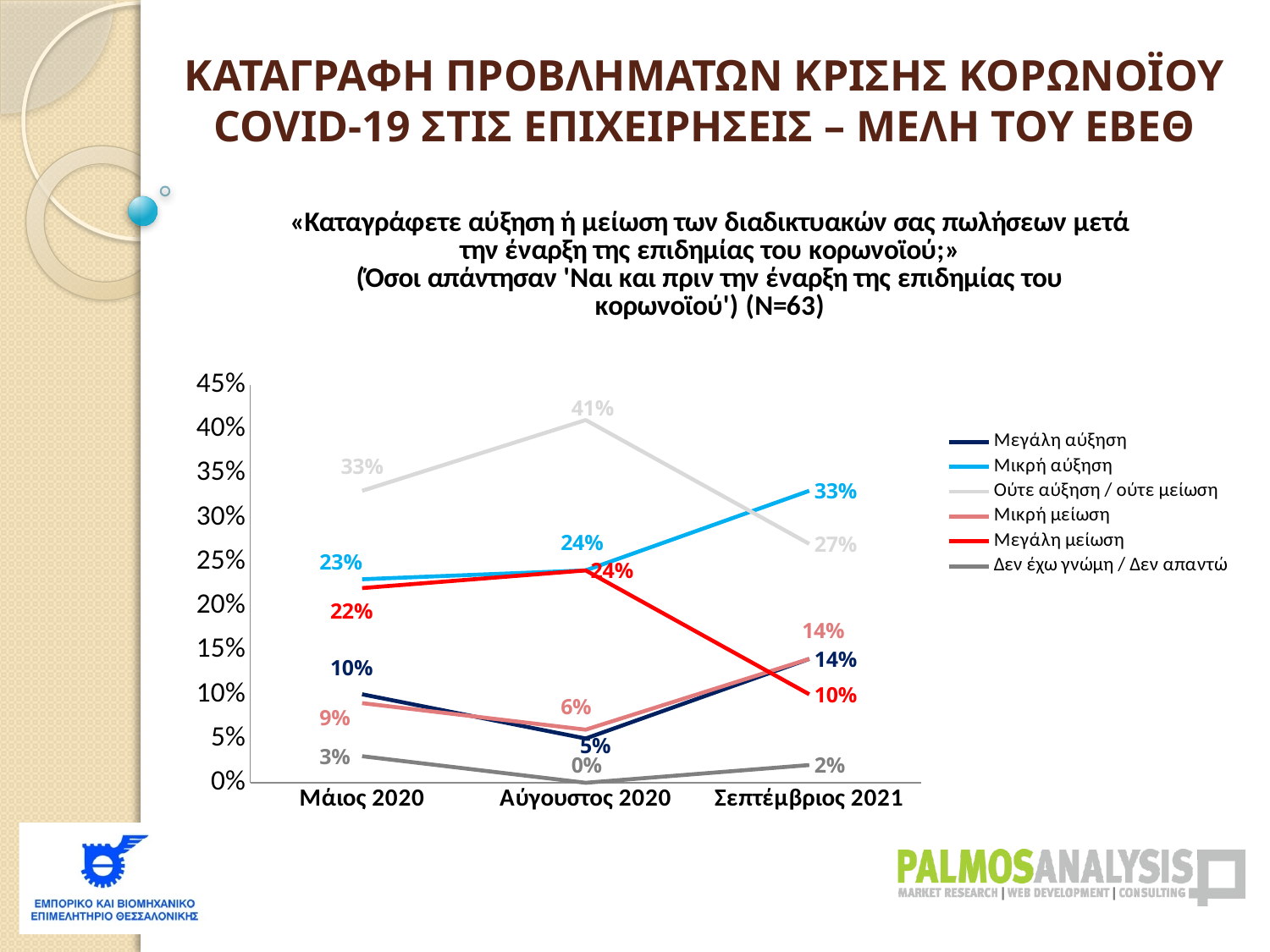
What is the difference between the Μικρή αύξηση values in Σεπτέμβριος 2021 and Μάιος 2020? 10% What type of chart is shown on the slide? line chart What is the value for Μικρή αύξηση in Σεπτέμβριος 2021? 33% How many time points are shown on the x axis? 3 How many series does the legend list? 6 Does the Μεγάλη μείωση series rise or fall from Αύγουστος 2020 to Σεπτέμβριος 2021? fall Which series has the lowest value in Μάιος 2020? Δεν έχω γνώμη / Δεν απαντώ Which is larger in Σεπτέμβριος 2021: Μικρή αύξηση or Ούτε αύξηση / ούτε μείωση? Μικρή αύξηση What is the value for Ούτε αύξηση / ούτε μείωση in Αύγουστος 2020? 41% What colour is the line for Μεγάλη μείωση? red Which series has the highest value in Αύγουστος 2020? Ούτε αύξηση / ούτε μείωση What is the value for Μεγάλη μείωση in Μάιος 2020? 22%